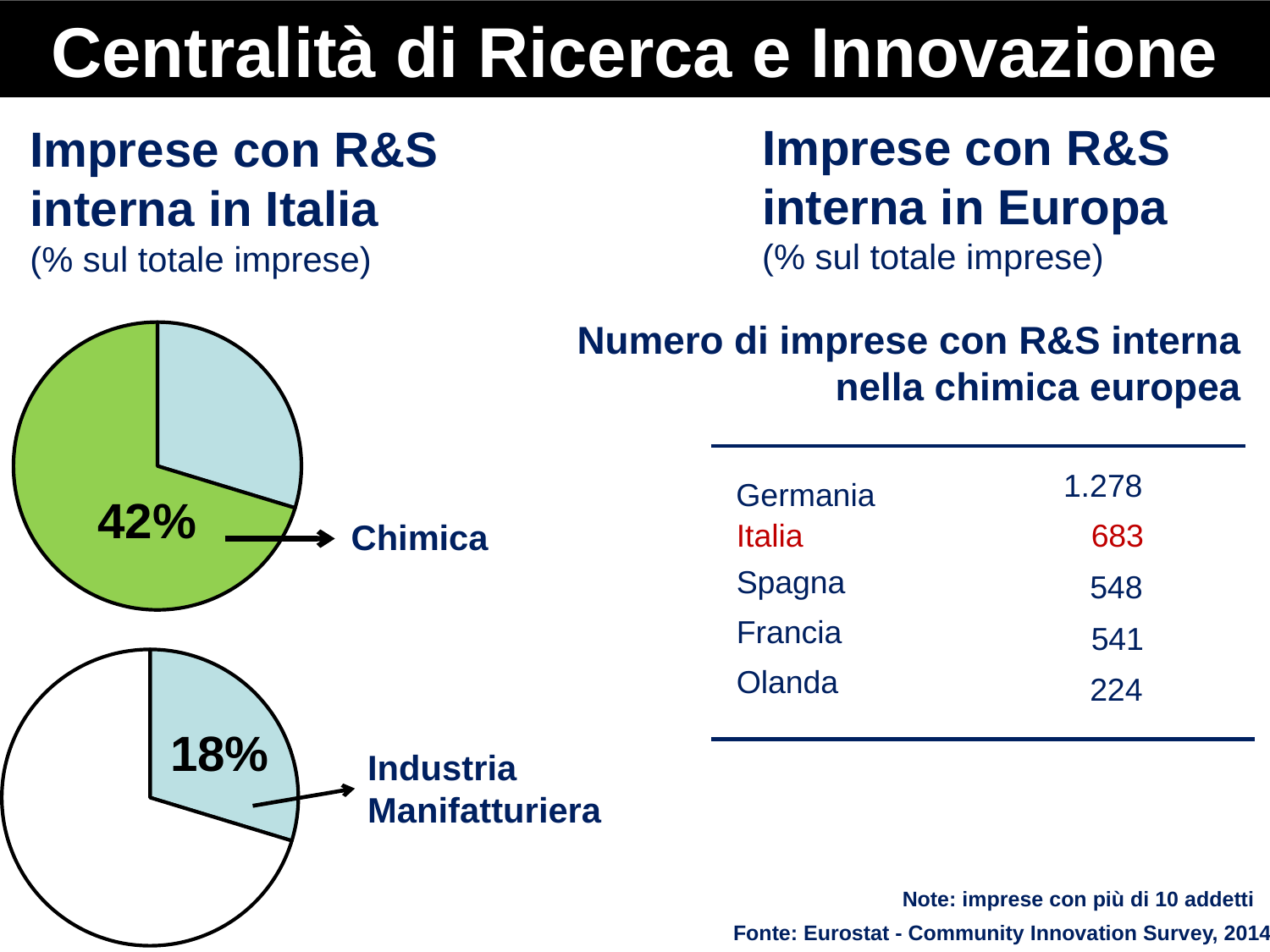
What is the title above the two pie charts on the left? Imprese con R&S interna in Italia (% sul totale imprese) In the top pie chart, what share of companies in the chemical sector (Chimica) have internal R&D? 42% What is the difference in percentage points between the Chimica share (42%) and the Industria Manifatturiera share (18%)? 24 percentage points Is the share shown in the top pie chart for Chimica greater or less than 50%? less How many pie charts are on the slide? 2 In the table 'Numero di imprese con R&S interna nella chimica europea', what is the value for Italia? 683 In the table 'Numero di imprese con R&S interna nella chimica europea', which country has the highest number? Germania In the bottom pie chart, what share of companies in manufacturing (Industria Manifatturiera) have internal R&D? 18% What colour is the 42% slice in the top pie chart? Green What kind of charts are shown on the left side of the slide? Pie charts Which sector has the higher share of companies with internal R&D, Chimica or Industria Manifatturiera? Chimica Is the share shown in the bottom pie chart for Industria Manifatturiera greater or less than 20%? less